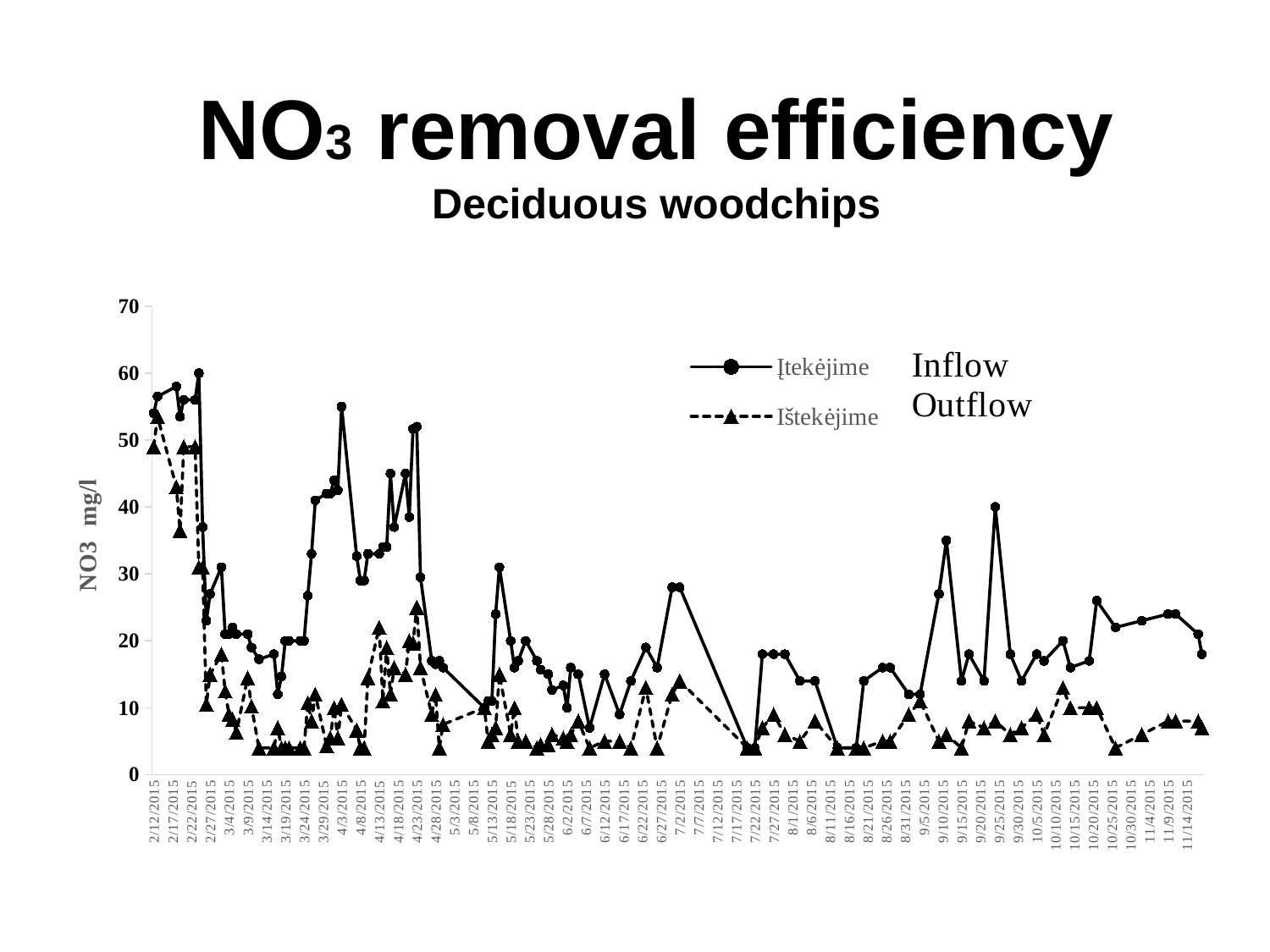
Which series reaches the highest value on the chart? Įtekėjime Is the Inflow (Įtekėjime) value around 4/3/2015 greater or less than 50? greater Around 9/25/2015, which series has the larger value, Įtekėjime or Ištekėjime? Įtekėjime Is the Outflow (Ištekėjime) value around 7/17/2015 greater or less than 10? less Is the Outflow (Ištekėjime) value around 4/3/2015 greater or less than 20? less Around 4/3/2015, which series has the larger value, Įtekėjime or Ištekėjime? Įtekėjime What kind of chart is shown on the slide? Line chart Does the Outflow (Ištekėjime) series rise or fall between 2/12/2015 and 3/9/2015? fall What is the label of the y axis? NO3 mg/l How many series does the legend list? 2 Which legend entry is drawn with a dashed line and triangle markers? Ištekėjime